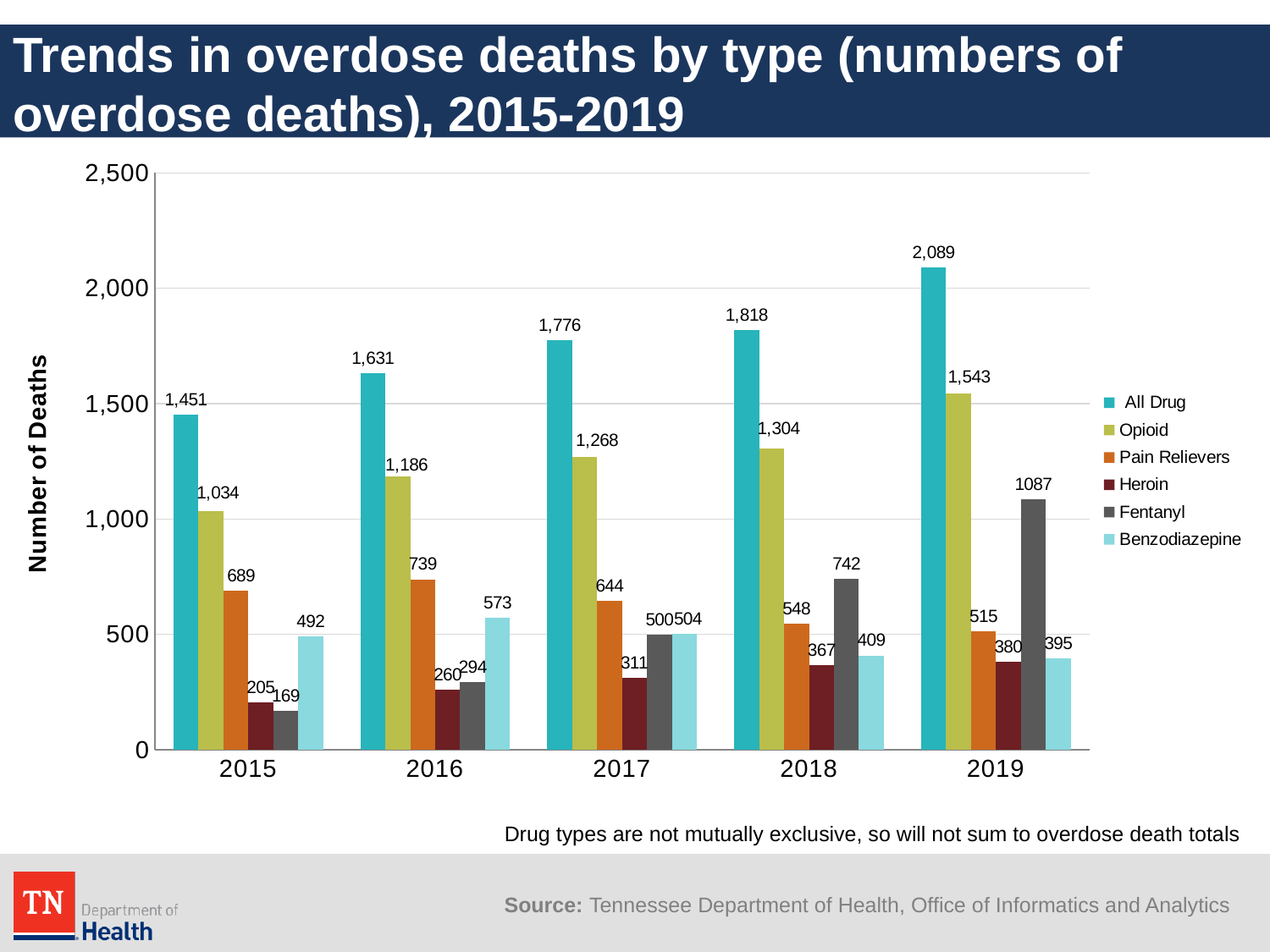
In which year is the All Drug value highest? 2019 What is the number of All Drug overdose deaths in 2019? 2,089 What is the difference between the All Drug values for 2019 and 2015? 638 In which year is the Fentanyl value lowest? 2015 How many series does the legend list? 6 Does the All Drug value rise or fall from 2015 to 2019? rise What is the value for Fentanyl in 2018? 742 What is the value for Heroin in 2015? 205 Is the Opioid value for 2019 greater or less than 1,500? greater Which is larger, the Pain Relievers value in 2016 or in 2019? 2016 How many years are shown on the x axis? 5 By how much did the Fentanyl value increase from 2018 to 2019? 345